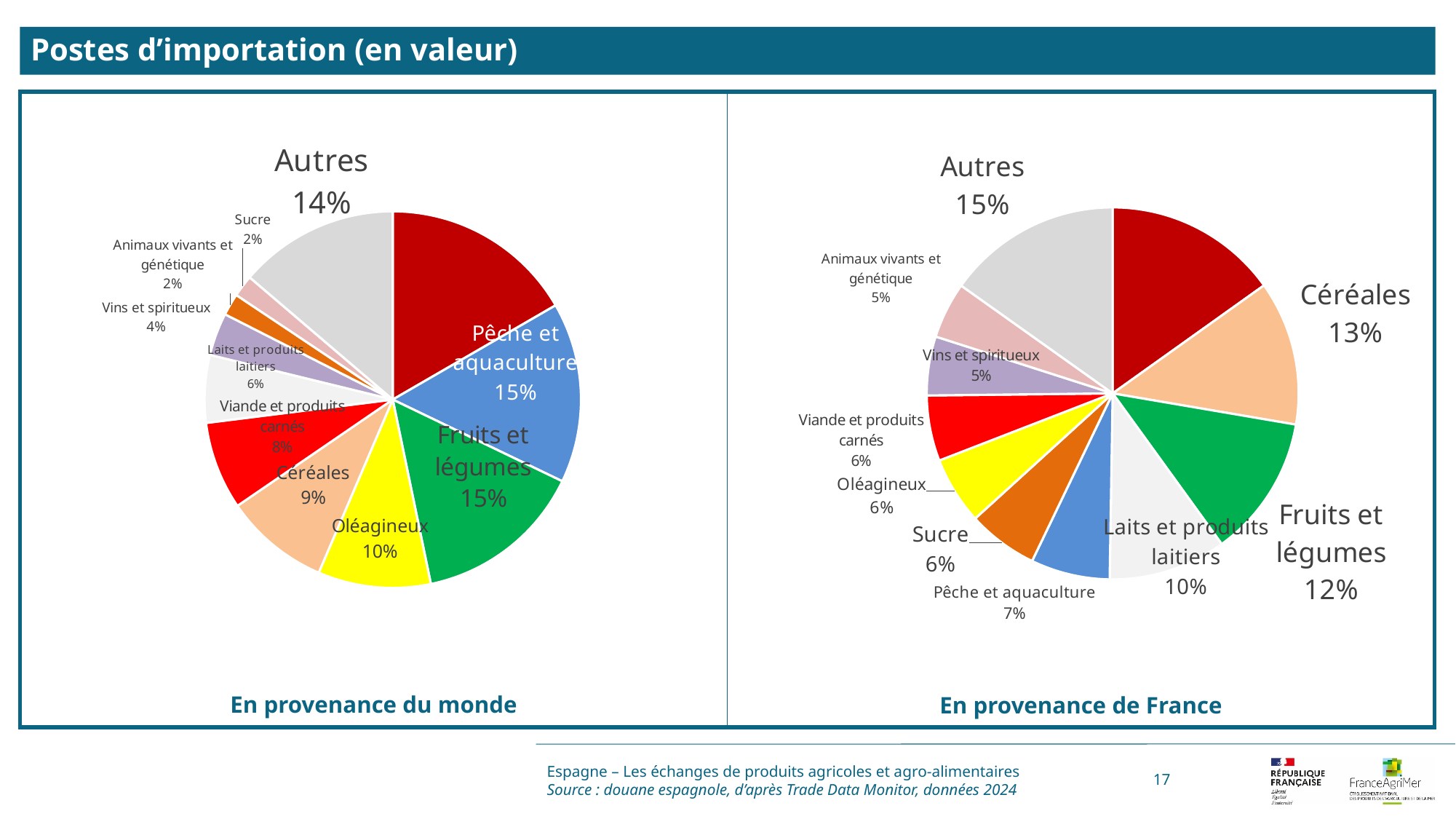
In the 'En provenance du monde' pie chart, what is the difference in percentage points between Fruits et légumes and Viande et produits carnés? 7 In the 'En provenance de France' pie chart, what is the difference in percentage points between Autres and Vins et spiritueux? 10 What is the title of the slide? Postes d'importation (en valeur) In the 'En provenance du monde' pie chart, what share is Céréales? 9% In the 'En provenance du monde' pie chart, which is larger: Oléagineux or Laits et produits laitiers? Oléagineux What type of chart is used on this slide? Pie chart In the 'En provenance de France' pie chart, what share is Laits et produits laitiers? 10% In the 'En provenance de France' pie chart, what share is Céréales? 13% In the 'En provenance de France' pie chart, what share is Pêche et aquaculture? 7% In the 'En provenance du monde' pie chart, what share is Vins et spiritueux? 4% In the 'En provenance du monde' pie chart, what share is Oléagineux? 10% Which chart shows a larger share for Céréales: 'En provenance du monde' or 'En provenance de France'? En provenance de France